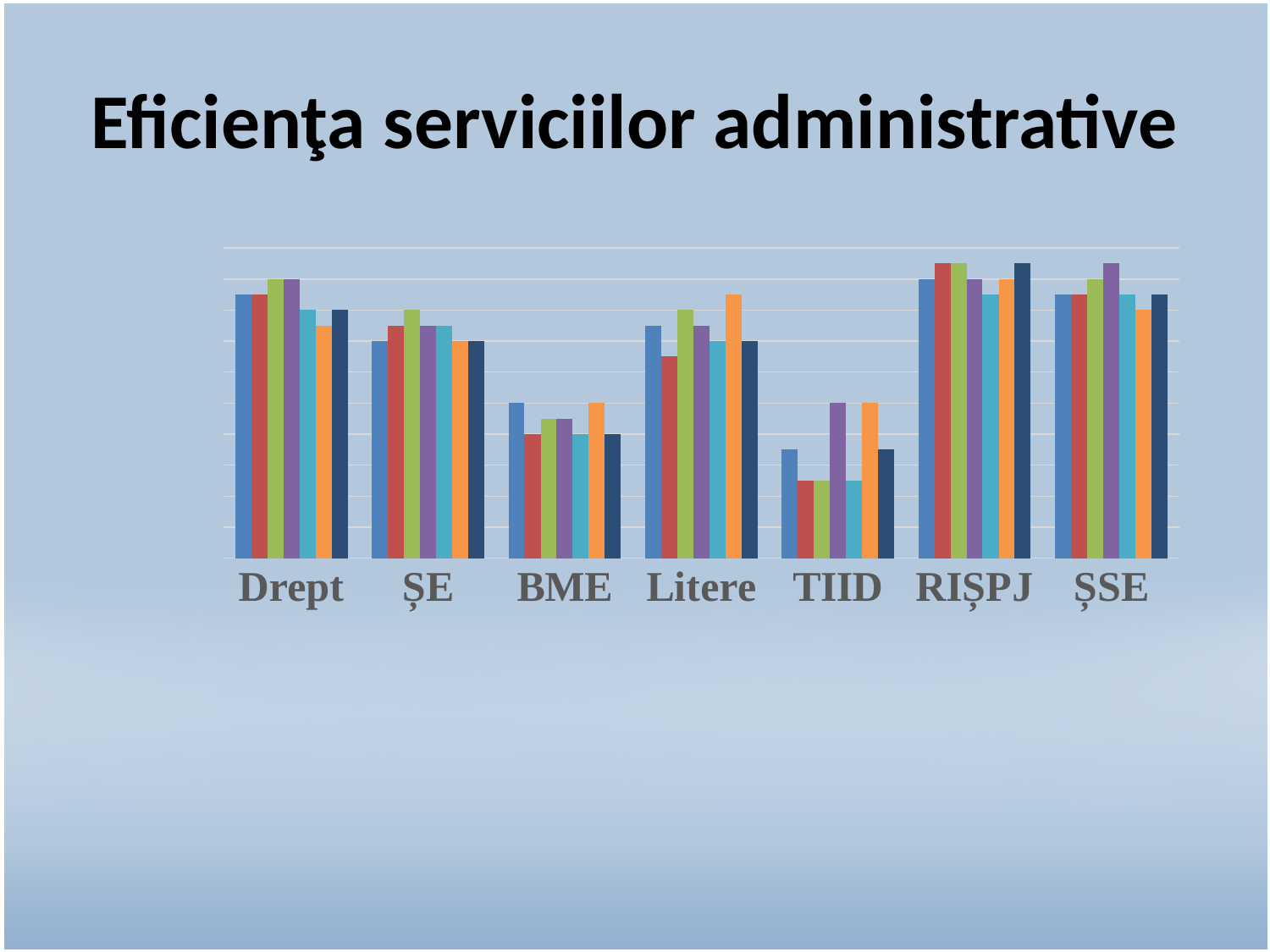
Which category contains the shortest bar in the chart? TIID Which category has taller bars overall, RIȘPJ or BME? RIȘPJ What is the label of the first category on the x axis? Drept Are the bars for Drept taller or shorter than the bars for BME? taller Which category has the tallest bars overall in the chart? RIȘPJ What kind of chart is shown on the slide? bar chart How many bars are plotted for each category in the chart? 7 Within the TIID category, is the orange bar taller or shorter than the red bar? taller How many categories are shown on the x axis of the chart? 7 What is the title of the slide containing the chart? Eficienţa serviciilor administrative